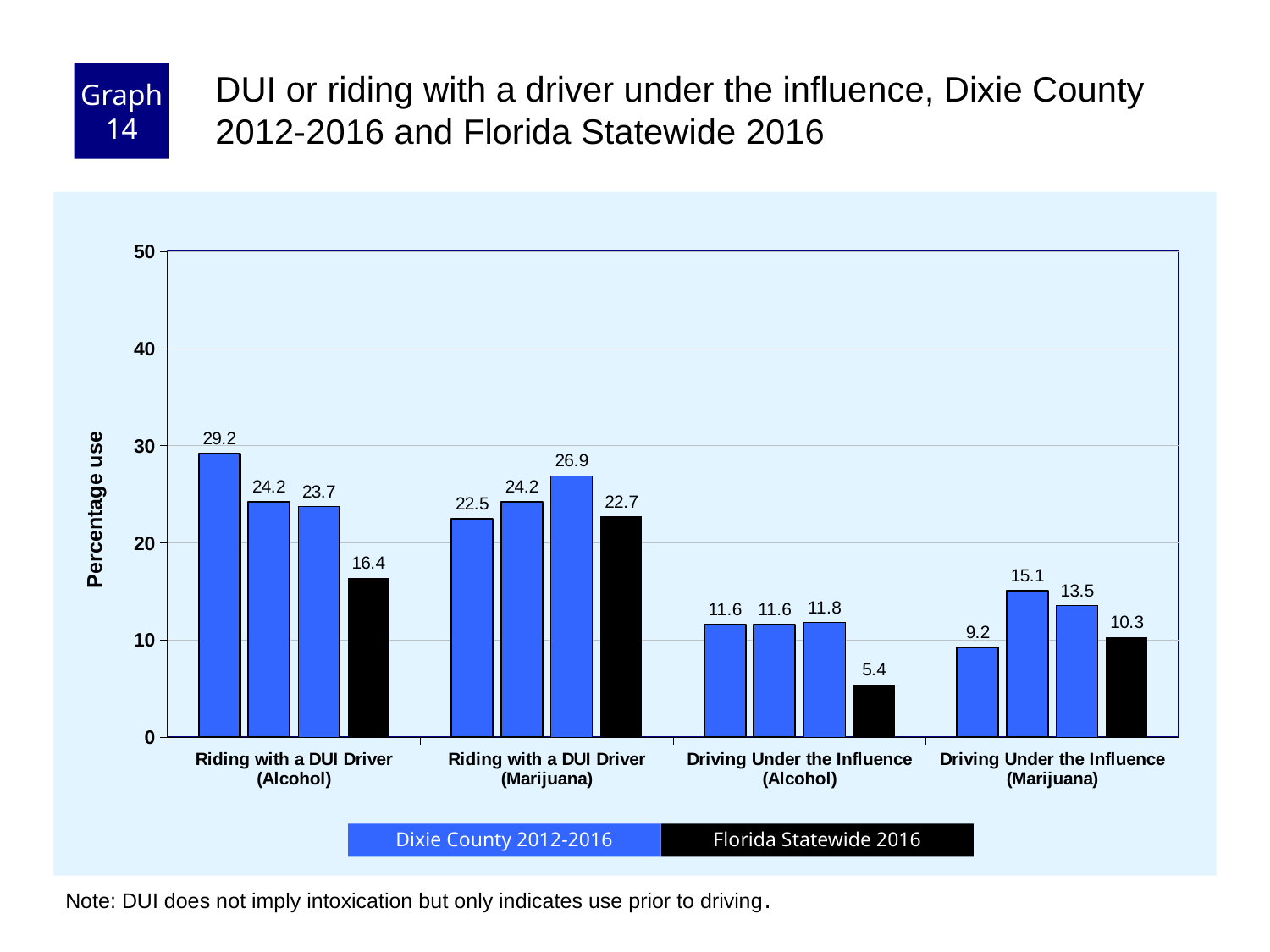
Which is larger: the Florida Statewide 2016 value for Riding with a DUI Driver (Marijuana) or for Driving Under the Influence (Marijuana)? Riding with a DUI Driver (Marijuana) What is the highest value shown for Riding with a DUI Driver (Marijuana)? 26.9 What is the value of the leftmost Dixie County 2012-2016 bar for Riding with a DUI Driver (Alcohol)? 29.2 Which category has the lowest Florida Statewide 2016 value? Driving Under the Influence (Alcohol) What kind of chart is shown on the slide? Bar chart What is the Florida Statewide 2016 value for Riding with a DUI Driver (Alcohol)? 16.4 What is the Florida Statewide 2016 value for Driving Under the Influence (Alcohol)? 5.4 Which category has the highest Florida Statewide 2016 value? Riding with a DUI Driver (Marijuana) How many series does the legend list? 2 How many categories are shown on the x axis? 4 What is the difference between the Florida Statewide 2016 values for Riding with a DUI Driver (Alcohol) and Driving Under the Influence (Alcohol)? 11.0 What is the Florida Statewide 2016 value for Driving Under the Influence (Marijuana)? 10.3